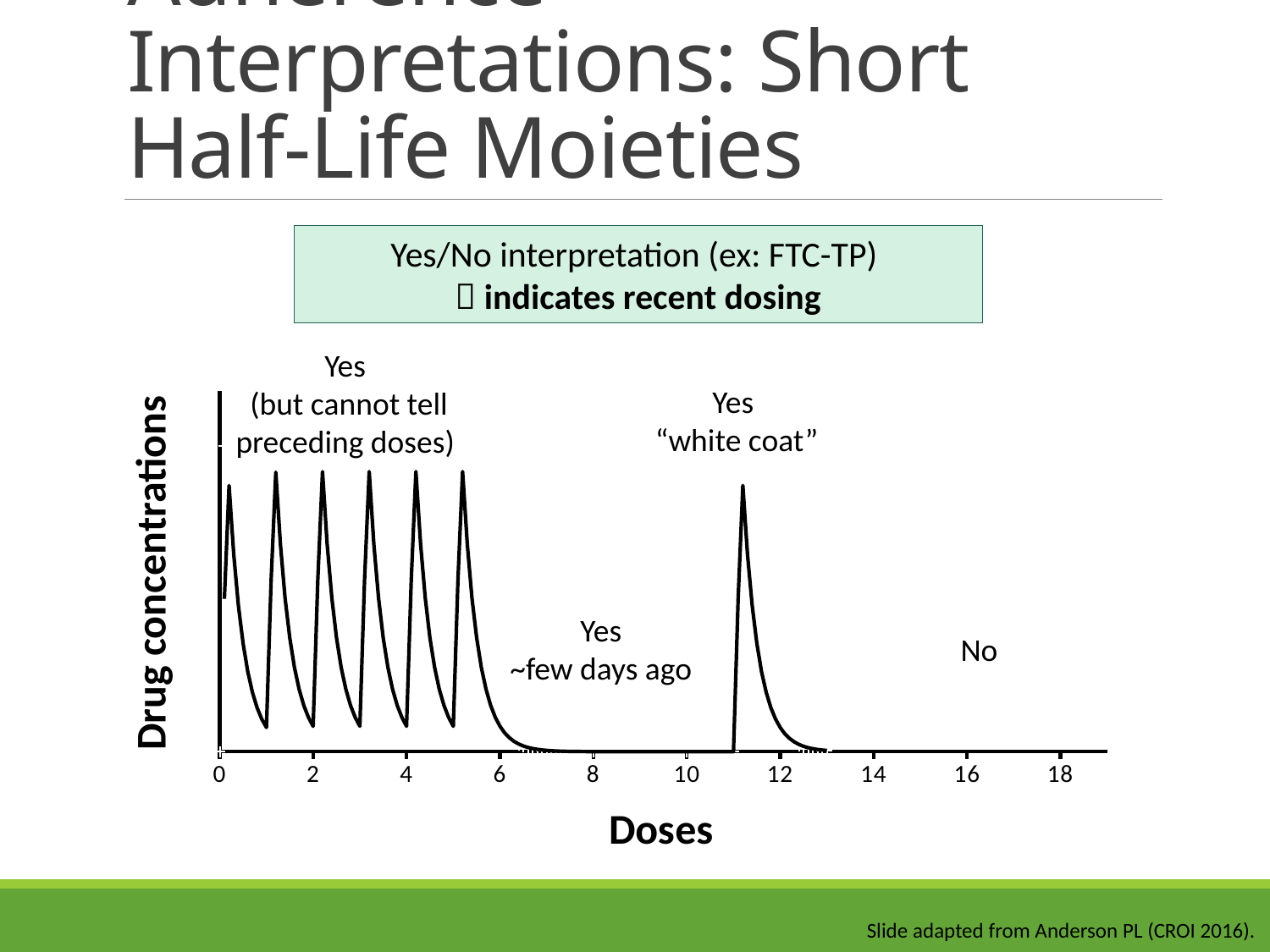
Is the drug concentration at dose 16 greater or less than the concentration at the peak near dose 11? Less What is the highest tick value shown on the x axis? 18 How many peaks does the line show in total across the chart? 7 Does the drug concentration rise or fall immediately after the isolated peak near dose 11? Fall How many peaks does the line show in the first cluster of doses (before the concentration drops to near zero)? 6 Is the peak concentration near dose 5 greater or less than the peak concentration near dose 11? Greater What interval separates the tick marks on the x axis? 2 Which annotation is placed over the region of the chart between doses 14 and 18, where the line stays at zero? No What is the label of the x axis of the chart? Doses Does the drug concentration rise or fall between dose 6 and dose 8? Fall What kind of chart is shown on the slide? Line chart What is the label of the y axis of the chart? Drug concentrations